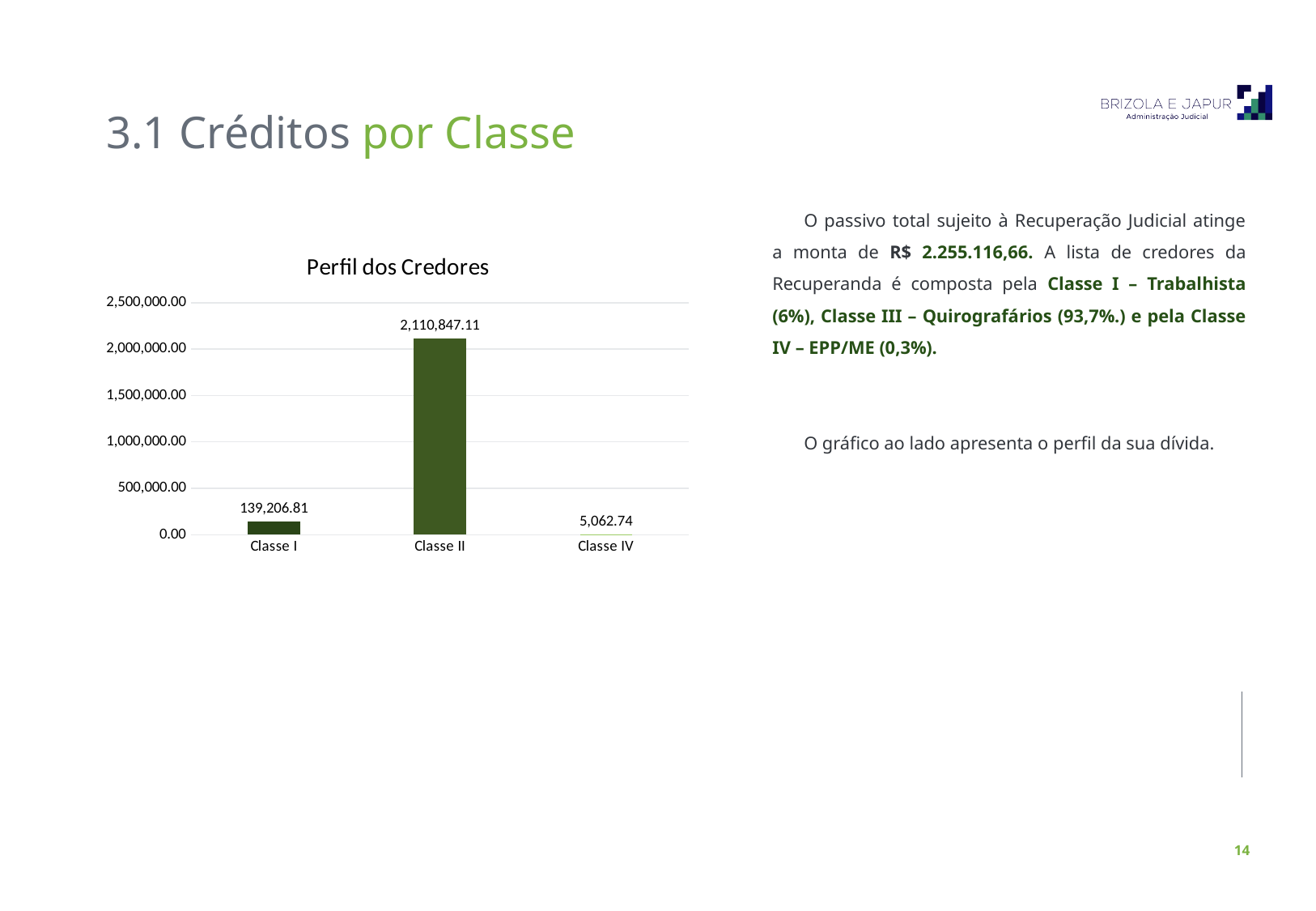
What is the value for Classe IV? 5,062.74 What is the title of the chart? Perfil dos Credores How many categories are shown in the chart? 3 What kind of chart is shown on the slide? bar chart What is the value for Classe II? 2,110,847.11 What is the difference between the values for Classe II and Classe I? 1,971,640.30 What is the difference between the values for Classe I and Classe IV? 134,144.07 Is the value for Classe II greater or less than 2,000,000.00? greater Which category has the lowest value? Classe IV Which category has the highest value? Classe II What is the value for Classe I? 139,206.81 Which is larger, the value for Classe I or the value for Classe IV? Classe I